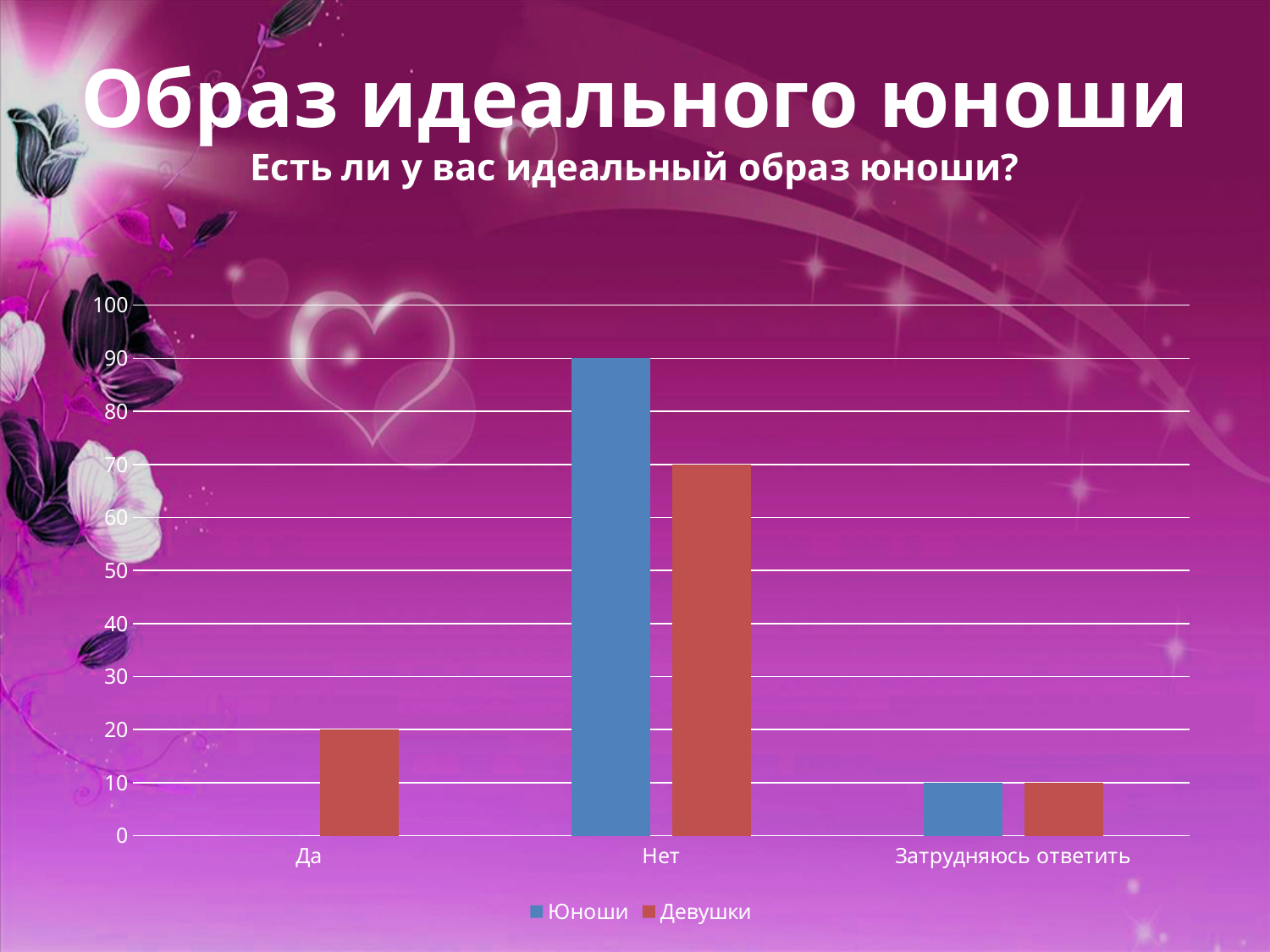
What is the value for Юноши in the Затрудняюсь ответить category? 10 Which category has the lowest value for Девушки? Затрудняюсь ответить In the Нет category, which series has the larger value, Юноши or Девушки? Юноши What is the difference between the Юноши and Девушки values in the Нет category? 20 How many series does the legend list? 2 What kind of chart is shown on the slide? bar chart What is the value for Девушки in the Да category? 20 How many categories are shown on the x axis? 3 Which series is shown in blue in the legend? Юноши What is the value for Юноши in the Нет category? 90 Which category has the highest value for Юноши? Нет What is the value for Девушки in the Нет category? 70